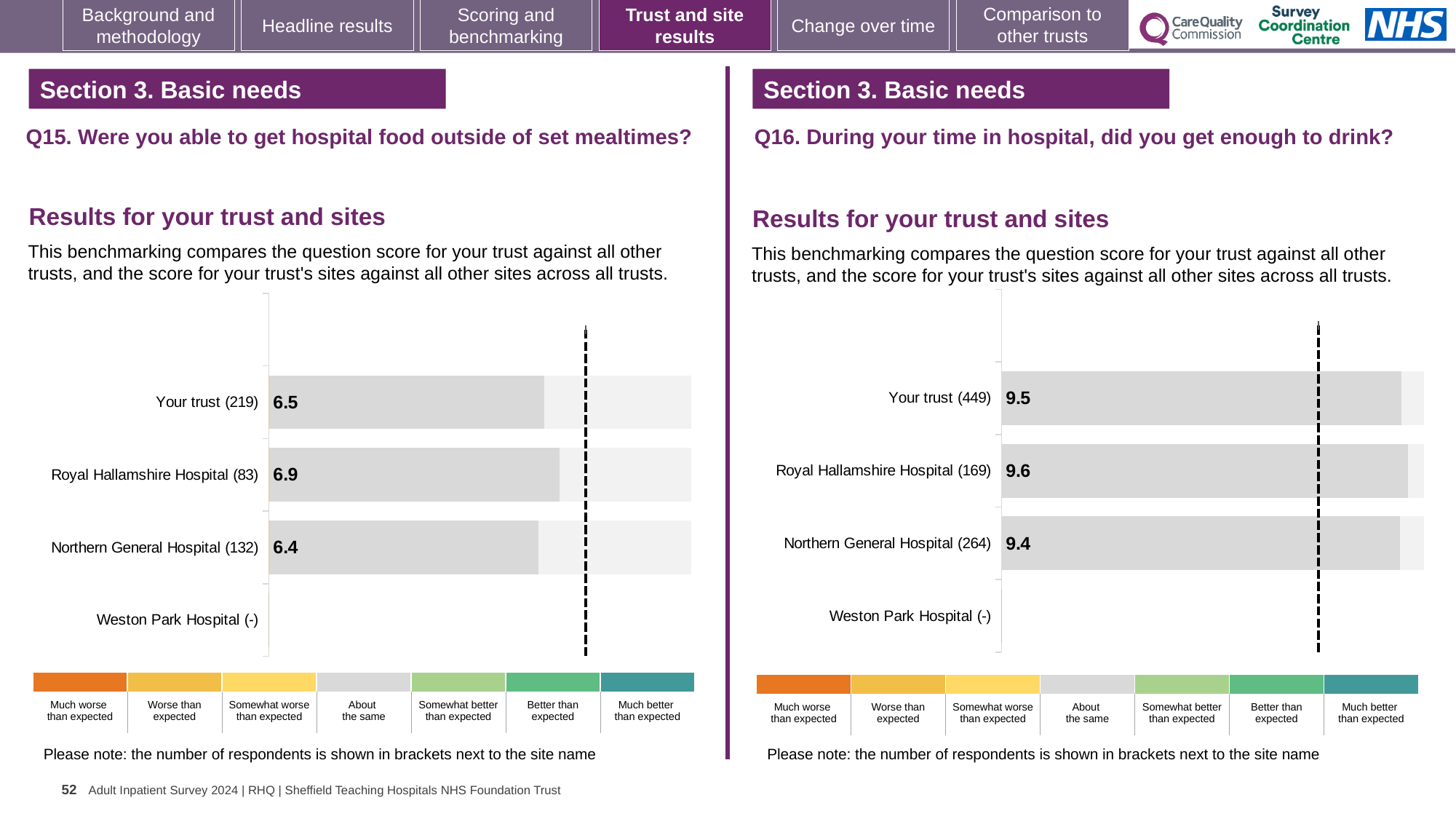
In the Q16 chart (right), which has the larger score, Your trust or Royal Hallamshire Hospital? Royal Hallamshire Hospital In the Q16 chart (right), how many respondents are shown for Your trust? 449 In the Q15 chart (left), what is the score for Your trust? 6.5 In the Q15 chart (left), what is the score for Royal Hallamshire Hospital? 6.9 In the Q15 chart (left), how many respondents are shown for Northern General Hospital? 132 What kind of chart is used for the Q15 results on the left? Bar chart How many categories (trust and sites) are listed on the Q16 chart (right)? 4 In the Q16 chart (right), what is the score for Your trust? 9.5 In the Q15 chart (left), which site or trust has the lowest score? Northern General Hospital In the Q16 chart (right), what is the score for Northern General Hospital? 9.4 In the Q15 chart (left), what is the difference between the scores for Royal Hallamshire Hospital and Northern General Hospital? 0.5 In the Q16 chart (right), which site has the highest score? Royal Hallamshire Hospital